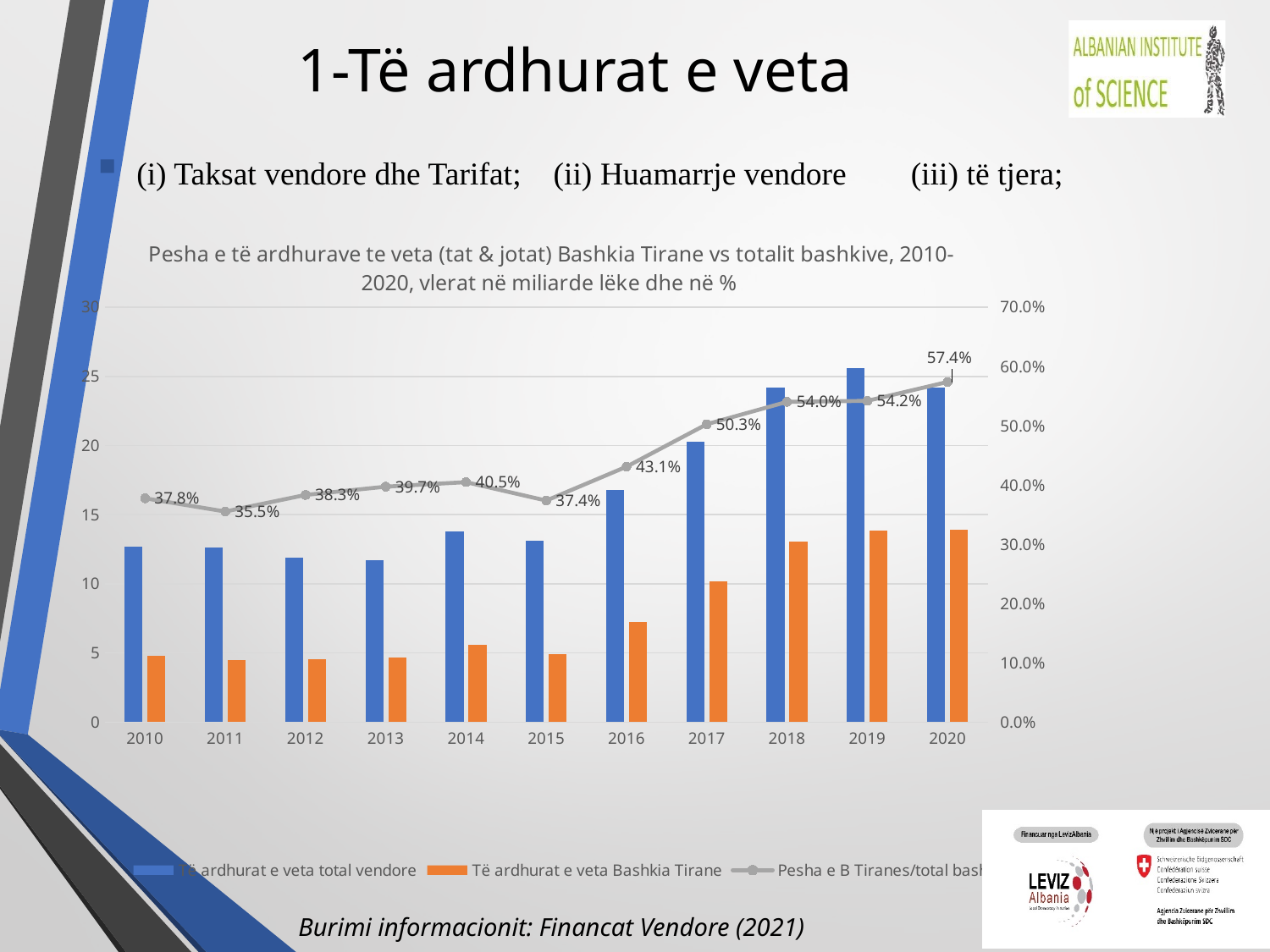
By how many percentage points did the line series increase from 2010 to 2020? 19.6 percentage points What is the value of the line series for 2017? 50.3% Does the line series rise or fall from 2015 to 2020? rise In which year does the line series have its lowest value? 2011 What is the value of the line series (Pesha e B Tiranes/total) for 2020? 57.4% Is the value of the orange bar (Të ardhurat e veta Bashkia Tirane) for 2010 greater or less than 10? less Which year has a higher value on the line series, 2016 or 2017? 2017 How many years are shown on the x axis of the chart? 11 How many series does the chart's legend list? 3 Is the value of the blue bar (Të ardhurat e veta total vendore) for 2019 greater or less than 20? greater In which year does the line series reach its highest value? 2020 What is the value of the line series for 2011? 35.5%